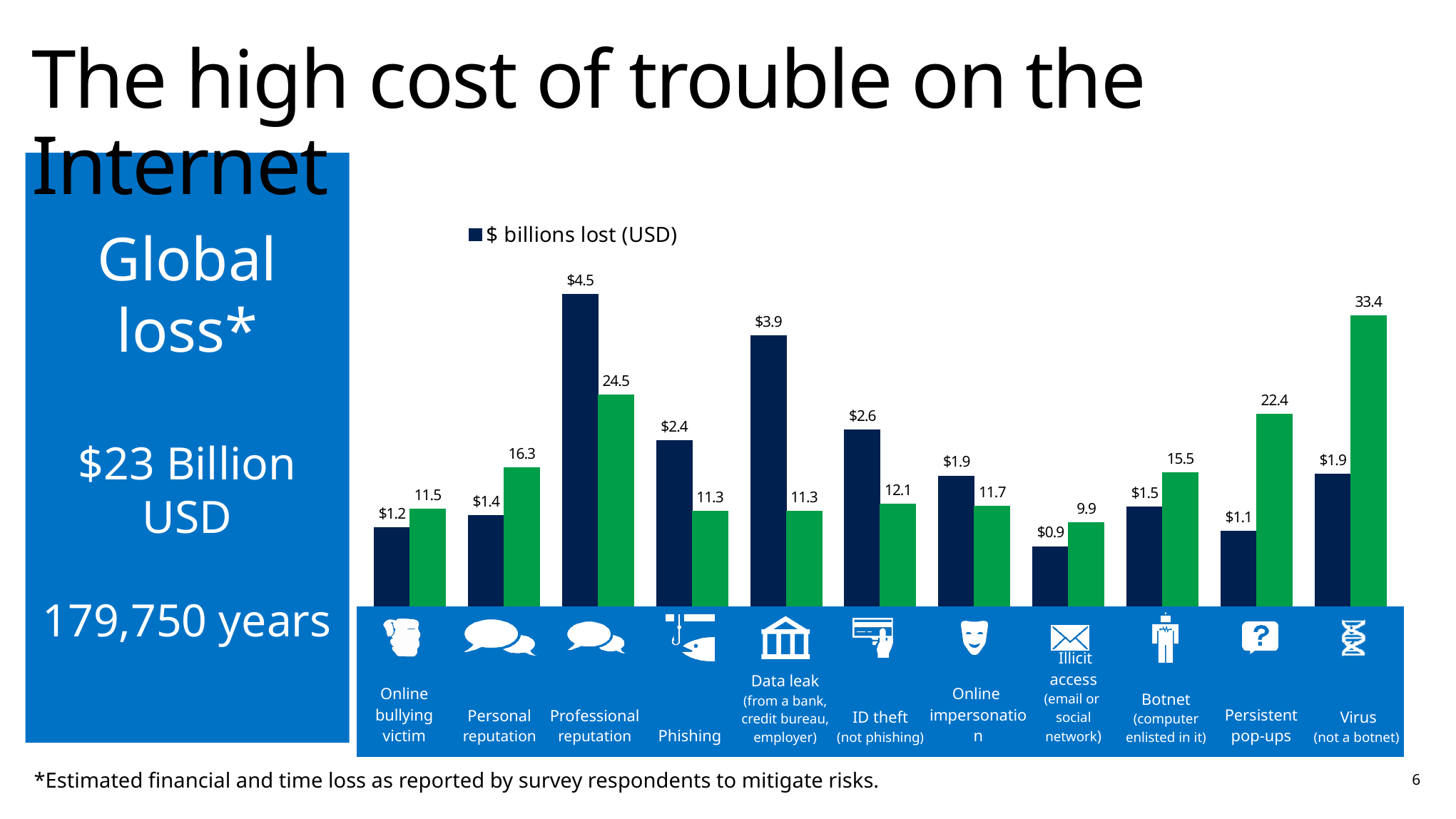
Which category has the highest $ billions lost (USD)? Professional reputation What is the value of $ billions lost (USD) for Phishing? $2.4 Which category has the lowest $ billions lost (USD)? Illicit access (email or social network) Which category has the highest green bar value? Virus (not a botnet) What is the value of $ billions lost (USD) for Professional reputation? $4.5 What is the value shown by the green bar for Virus (not a botnet)? 33.4 What type of chart is shown on the slide? Bar chart What is the difference in $ billions lost (USD) between Professional reputation and Data leak? $0.6 How many categories are shown on the x axis of the chart? 11 What is the value shown by the green bar for Botnet (computer enlisted in it)? 15.5 Which has a higher $ billions lost (USD): ID theft (not phishing) or Online impersonation? ID theft (not phishing) What is the difference between the green bar values for Virus (not a botnet) and Persistent pop-ups? 11.0